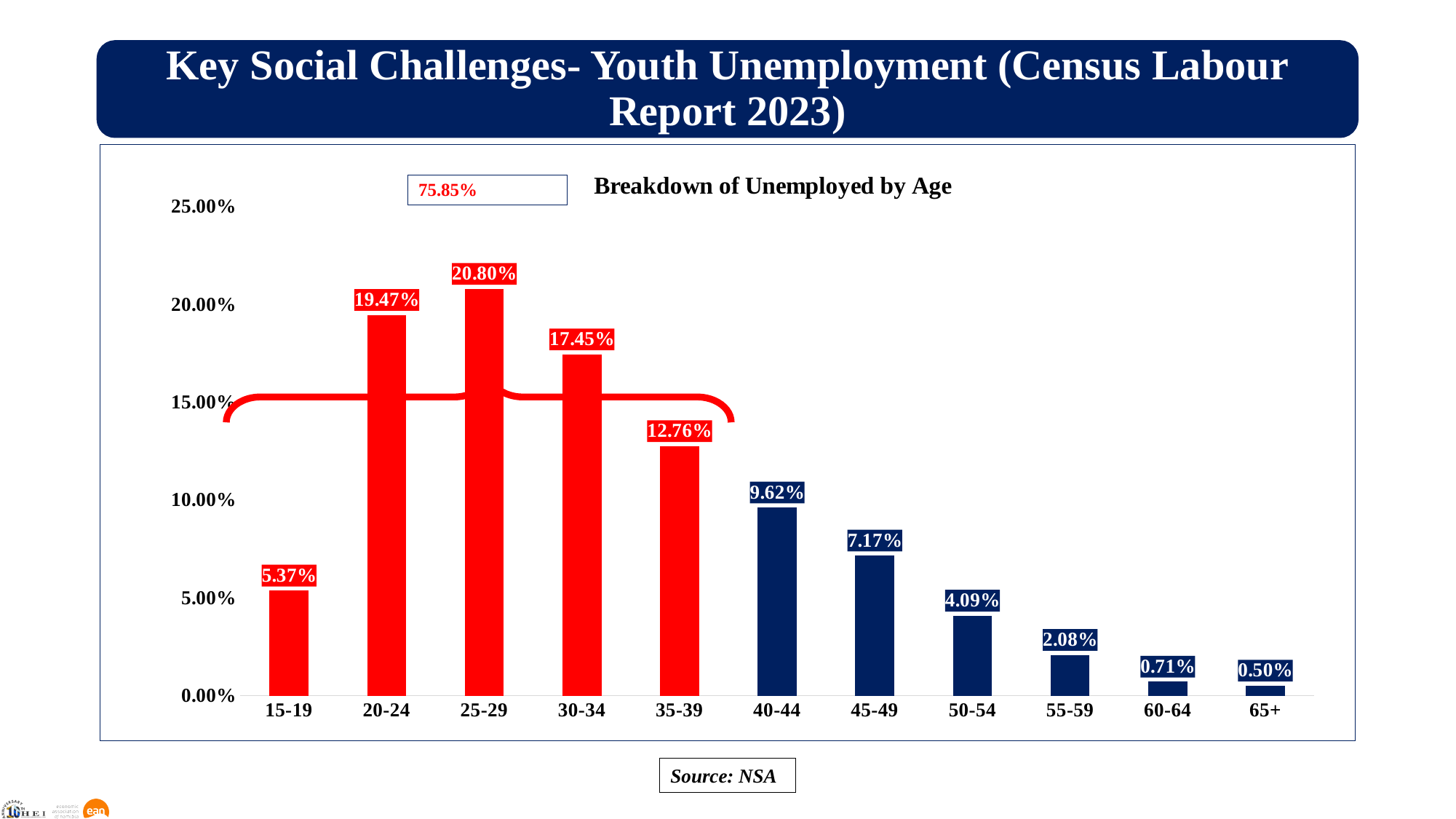
Do the values rise or fall along the x axis from 25-29 to 65+? fall What is the difference between the values for 20-24 and 30-34? 2.02% What is the value for the 40-44 age group? 9.62% Which is larger, the value for 15-19 or the value for 45-49? 45-49 What is the value for the 25-29 age group? 20.80% Which age group has the highest share of the unemployed? 25-29 Which age group has the lowest share of the unemployed? 65+ What is the title of the chart? Breakdown of Unemployed by Age What is the value for the 65+ age group? 0.50% Is the value for 35-39 greater or less than 15.00%? less How many age groups are shown on the x axis? 11 What kind of chart is shown on the slide? bar chart